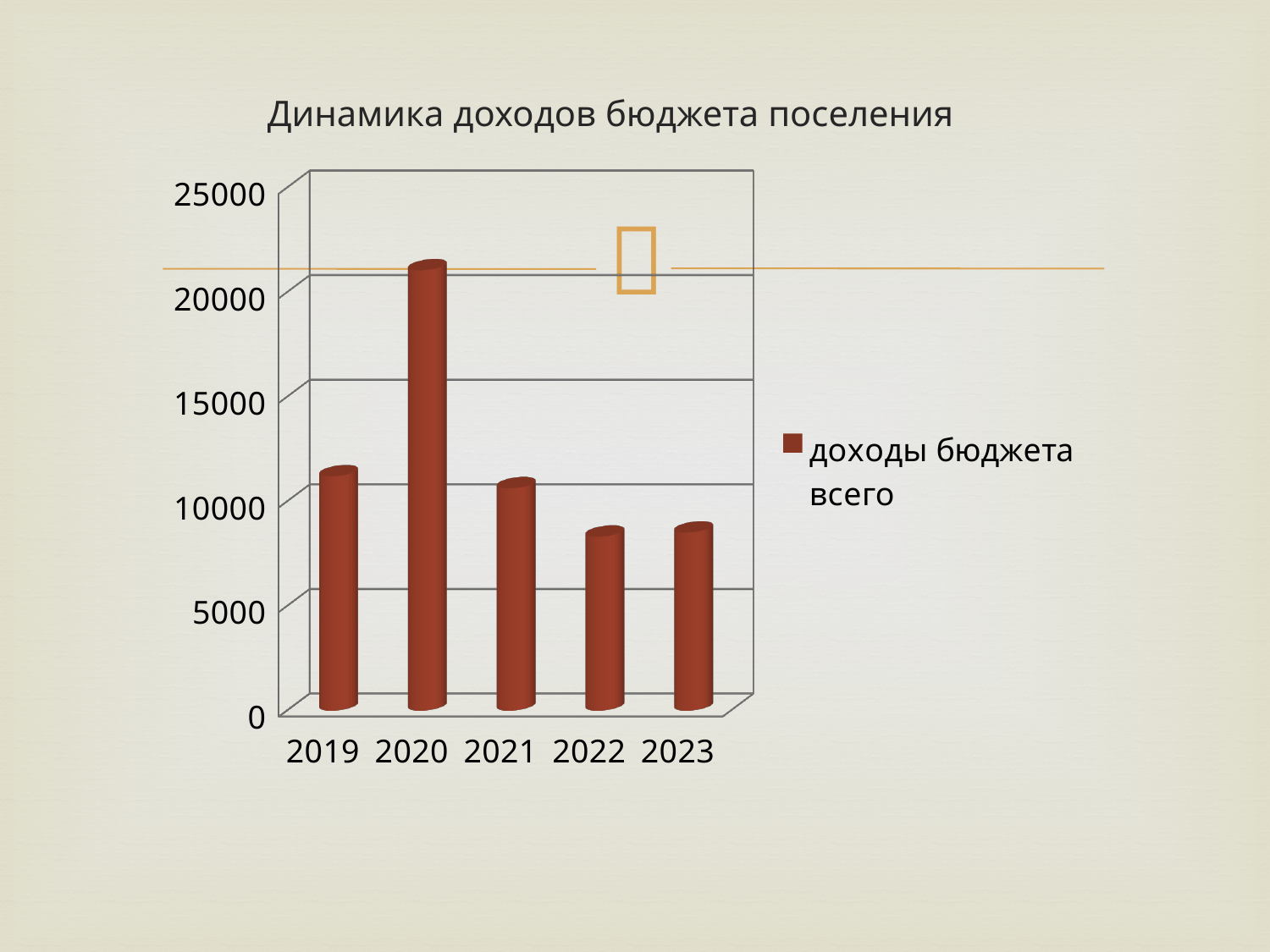
Is the value for 2019 greater or less than 10000? greater Do the values rise or fall from 2020 to 2022? fall Which year has the highest value for доходы бюджета всего? 2020 How many series does the legend list? 1 Is the value for 2021 greater or less than 15000? less What is the title of the chart? Динамика доходов бюджета поселения What is the name of the series shown in the legend? доходы бюджета всего What kind of chart is shown on the slide? bar chart Which is larger, the value for 2019 or the value for 2022? 2019 Is the value for 2022 greater or less than 10000? less How many years are shown on the x axis? 5